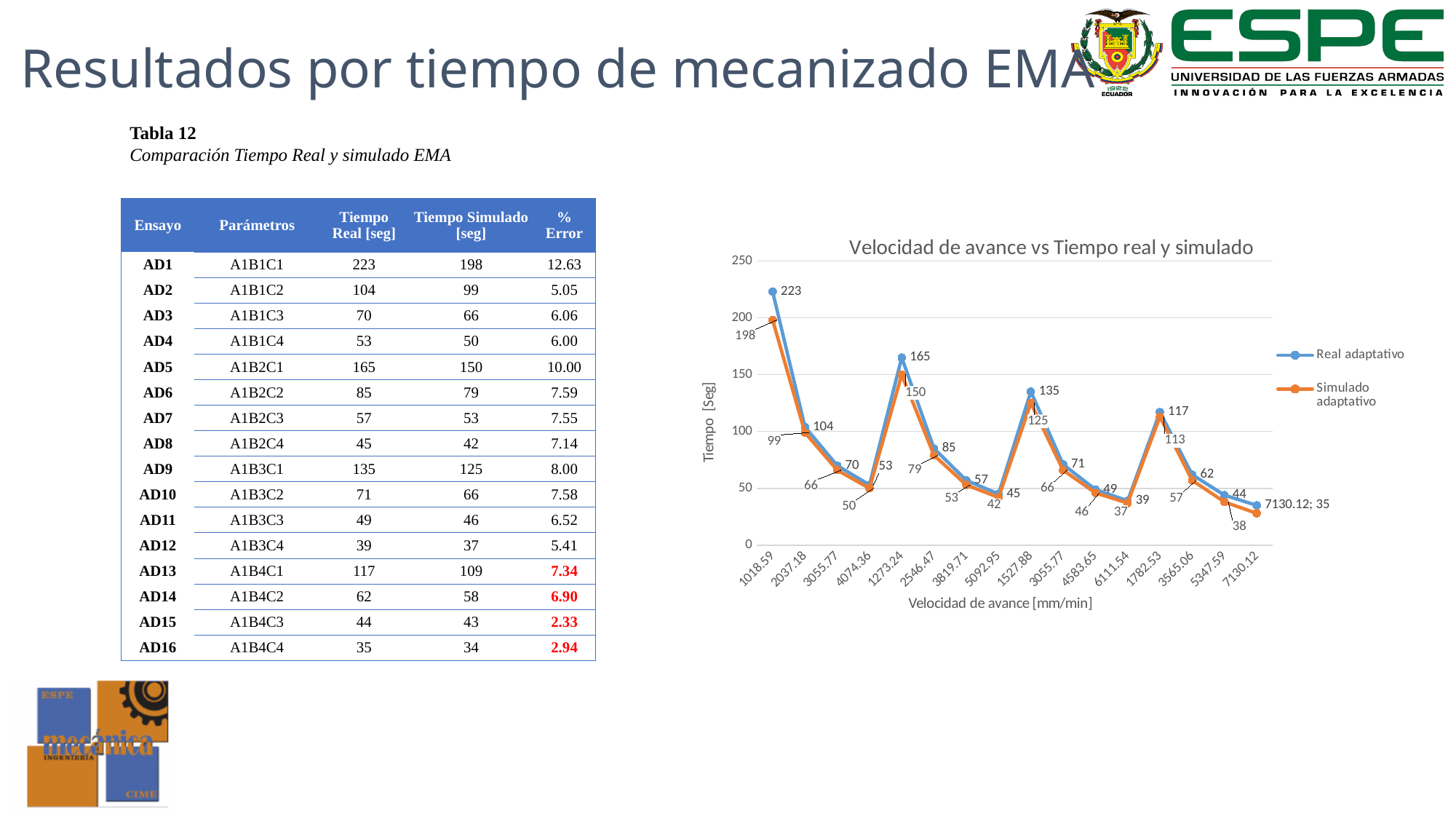
Do the Real adaptativo values rise or fall from 1018.59 to 4074.36 mm/min? fall How many series does the legend of the chart list? 2 At 1527.88 mm/min, which series has the larger value, Real adaptativo or Simulado adaptativo? Real adaptativo What kind of chart is shown on the slide? line chart At which velocidad de avance is the Real adaptativo series lowest? 7130.12 What is the difference between the Real adaptativo and Simulado adaptativo values at 1018.59 mm/min? 25 At which velocidad de avance is the Real adaptativo series highest? 1018.59 How many velocity categories are plotted along the x axis of the chart? 16 Is the Real adaptativo value at 1782.53 mm/min greater or less than 100? greater What is the Real adaptativo value at a velocidad de avance of 1018.59 mm/min? 223 What is the Simulado adaptativo value at a velocidad de avance of 1273.24 mm/min? 150 What is the title of the chart? Velocidad de avance vs Tiempo real y simulado